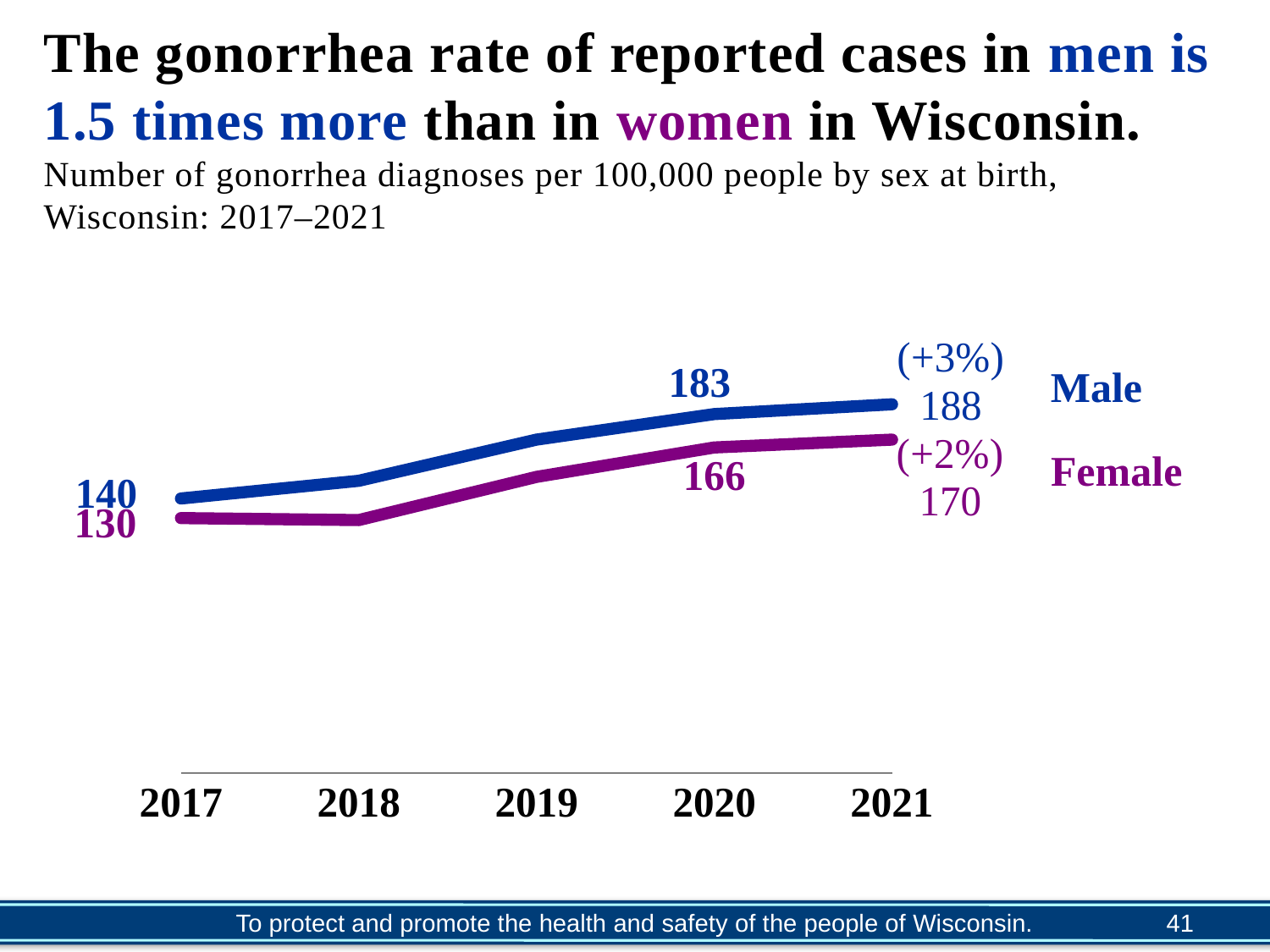
What is the difference between the Male values in 2020 and 2021? 5 Does the Female series rise or fall from 2017 to 2021? rise What is the Female value in 2021? 170 What is the Female value in 2017? 130 How many series does the chart show? 2 What is the Male value in 2017? 140 What is the difference between the Male and Female values in 2021? 18 What is the Male value in 2021? 188 How many years are shown on the x axis? 5 Which series has the higher value in 2020, Male or Female? Male What is the Male value in 2020? 183 What kind of chart is this? line chart